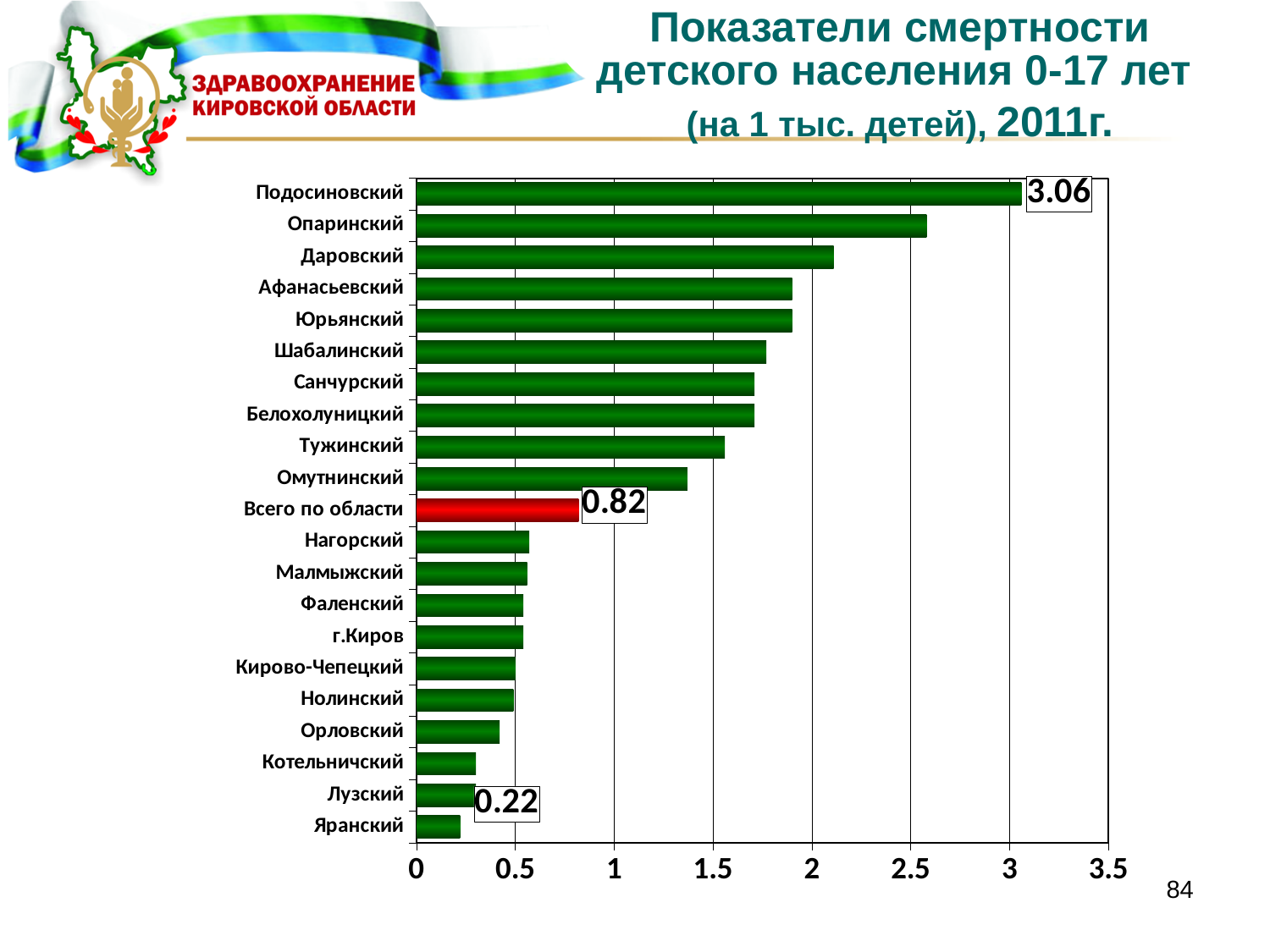
Is the value for Опаринский greater or less than 2.5? greater Which category has the lowest value? Яранский Is the value for Омутнинский greater or less than 1? greater What kind of chart is shown on the slide? bar chart Which has a larger value, Опаринский or Даровский? Опаринский Is the value for Нагорский greater or less than 1? less What is the value for Всего по области? 0.82 What is the difference between the values for Подосиновский and Всего по области? 2.24 What is the value for Подосиновский? 3.06 Which category has the highest value? Подосиновский How many categories are shown on the chart? 21 Which category's bar is coloured red? Всего по области